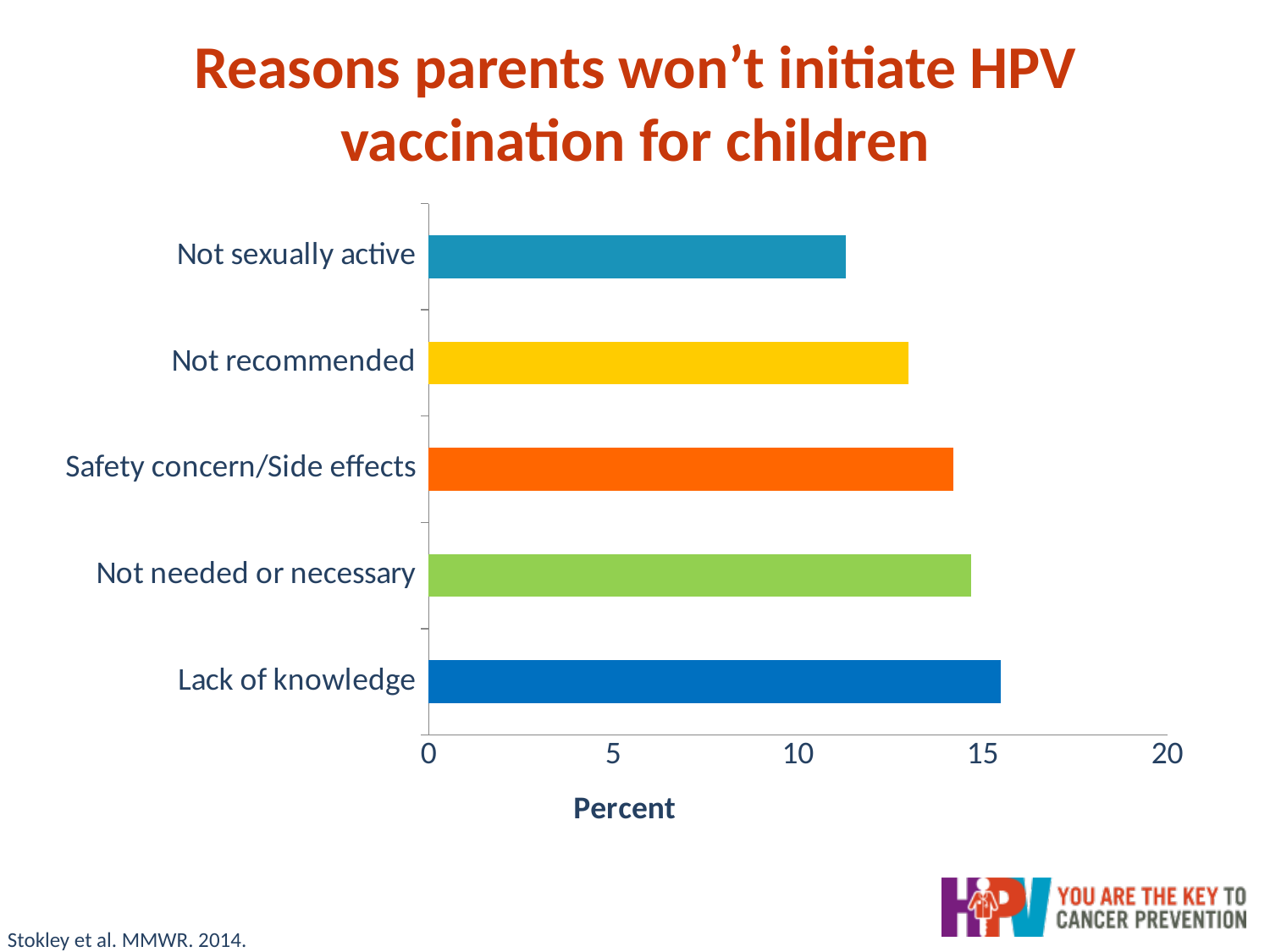
Which reason has the highest percentage in the chart? Lack of knowledge What is the title of the horizontal axis of the chart? Percent Is the value for Not recommended greater or less than 15? less Is the value for Not recommended greater or less than 10? greater Which is larger, the value for Not sexually active or the value for Not recommended? Not recommended Which reason has the lowest percentage in the chart? Not sexually active What kind of chart is shown on the slide? Bar chart Which is larger, the value for Lack of knowledge or the value for Not recommended? Lack of knowledge How many reasons (categories) are plotted in the chart? 5 What is the title of the chart? Reasons parents won't initiate HPV vaccination for children Is the value for Not sexually active greater or less than 10? greater